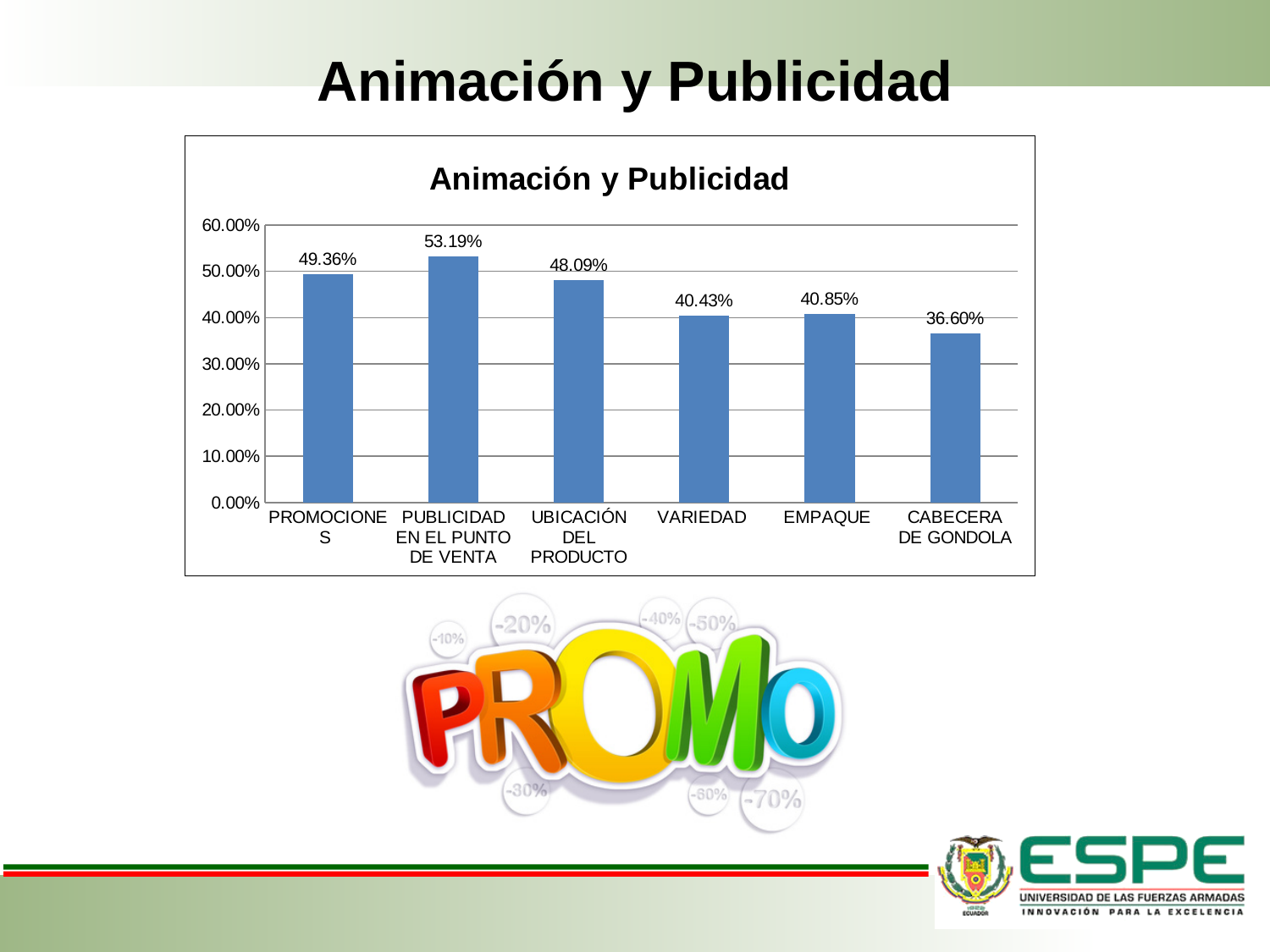
What is the difference between the values for PROMOCIONES and UBICACIÓN DEL PRODUCTO? 1.27% What is the value for CABECERA DE GONDOLA? 36.60% What kind of chart is shown? bar chart What is the value for VARIEDAD? 40.43% What is the title of the chart? Animación y Publicidad Which is larger, the value for PROMOCIONES or the value for EMPAQUE? PROMOCIONES Which category has the highest value? PUBLICIDAD EN EL PUNTO DE VENTA How many categories are shown on the x axis? 6 What is the value for PUBLICIDAD EN EL PUNTO DE VENTA? 53.19% Is the value for UBICACIÓN DEL PRODUCTO greater or less than 50.00%? less What is the difference between the values for PUBLICIDAD EN EL PUNTO DE VENTA and CABECERA DE GONDOLA? 16.59% Which category has the lowest value? CABECERA DE GONDOLA